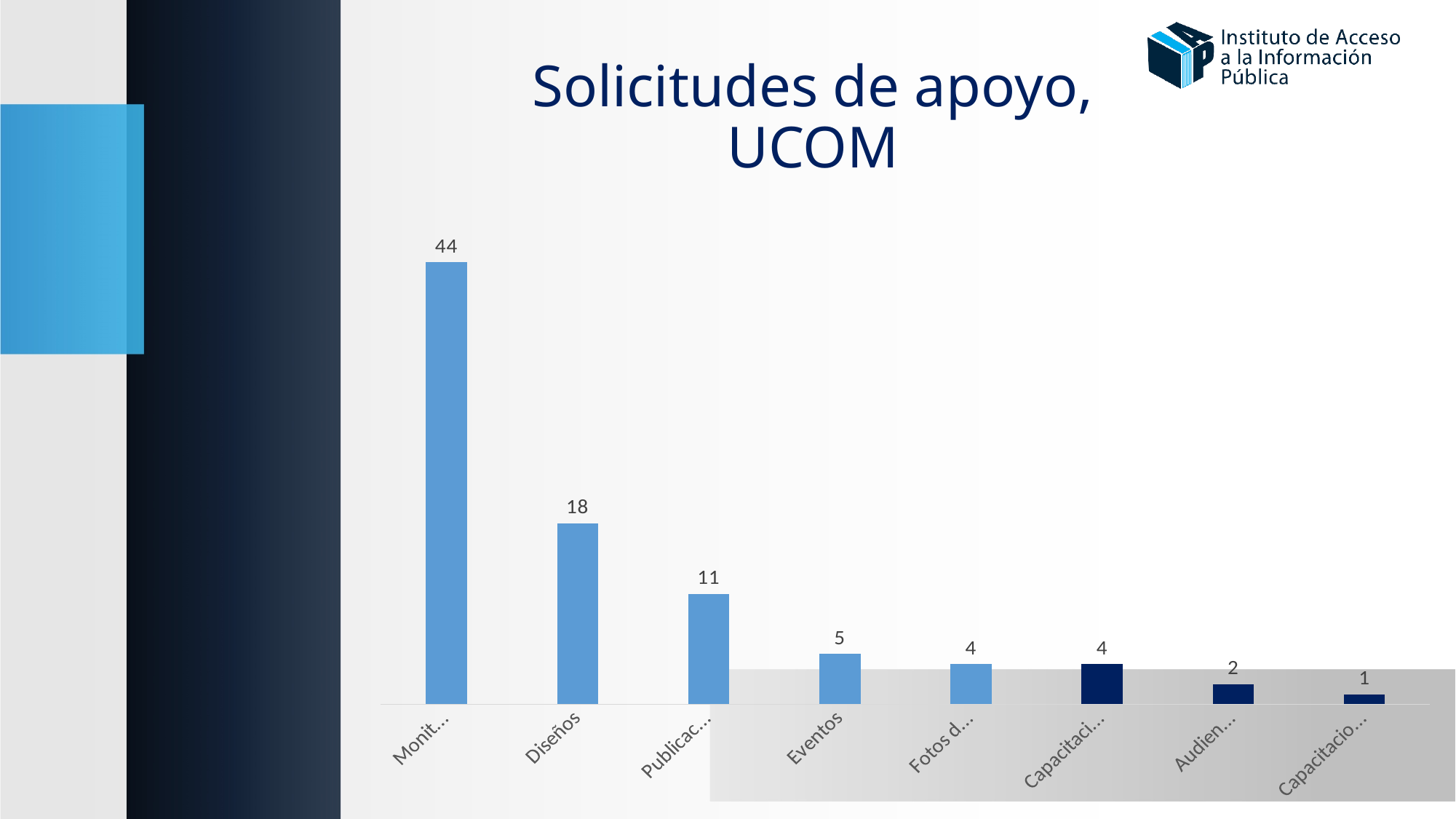
Which is larger, the value for Diseños or the value for Eventos? Diseños Do the bar values rise or fall from left to right across the chart? Fall What is the value of the last bar on the right, the lowest one? 1 What is the value of the third bar from the left? 11 What is the value for Diseños? 18 What is the value of the tallest bar, the first one on the left? 44 What kind of chart is shown on the slide? Bar chart What is the difference between the first bar on the left (44) and Diseños? 26 What is the difference between the value for Diseños and the value for Eventos? 13 What is the title of the slide containing the chart? Solicitudes de apoyo, UCOM What is the value for Eventos? 5 How many bars does the chart show? 8